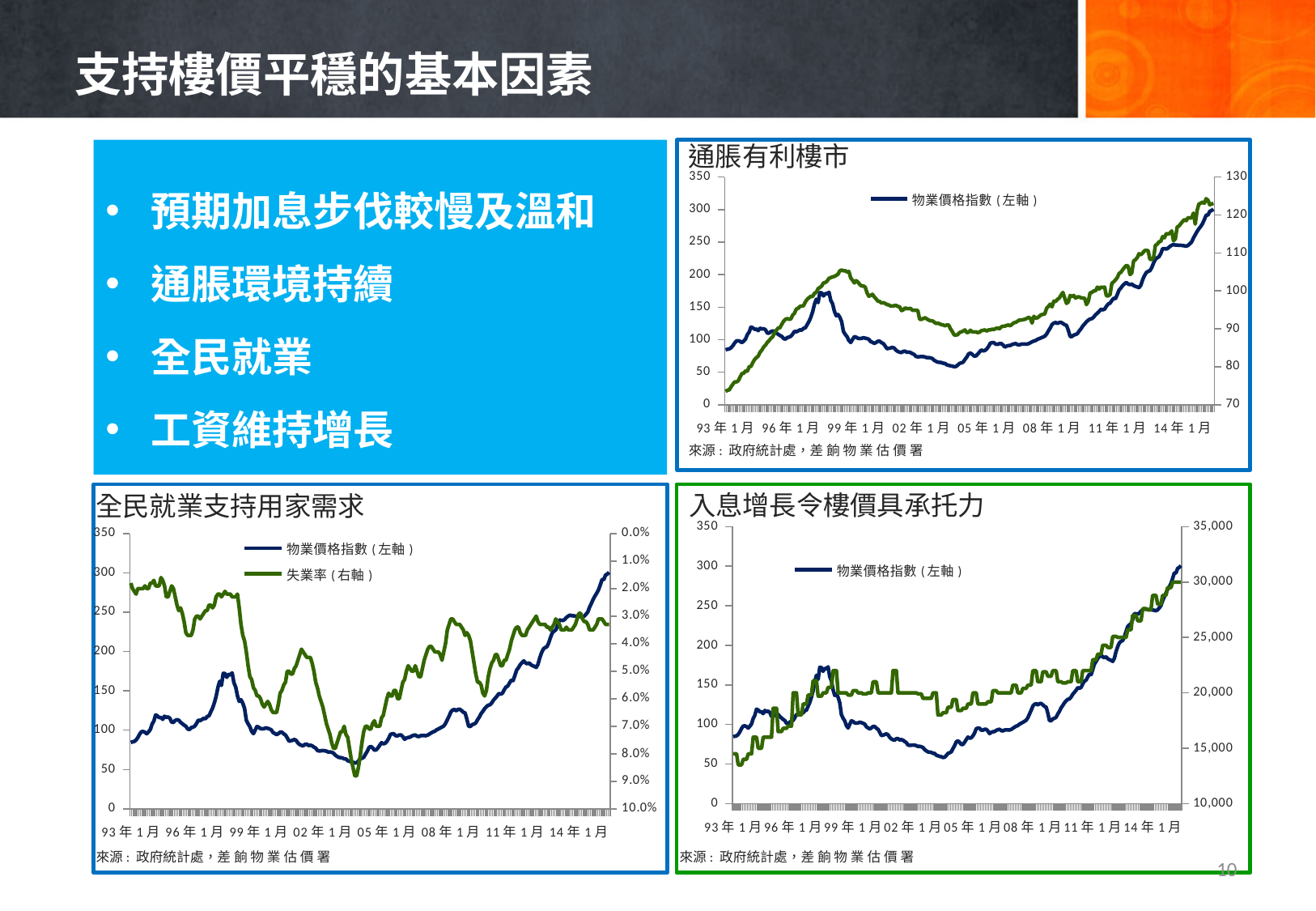
In the chart titled 通脹有利樓市, is the 物業價格指數 value at 05 年 1 月 greater or less than 100? less What kind of chart is the chart titled 通脹有利樓市? line chart What is the title of the chart in the top right of the slide? 通脹有利樓市 In the chart titled 全民就業支持用家需求, is the 物業價格指數 value at 14 年 1 月 greater or less than 200? greater In the chart titled 通脹有利樓市, does the 物業價格指數 rise or fall from 99 年 1 月 to 02 年 1 月? fall How many series does the legend of the chart titled 全民就業支持用家需求 list? 2 In the chart titled 全民就業支持用家需求, which series is plotted on the right axis according to the legend? 失業率 (右軸) How many year labels are shown on the x axis of the chart titled 入息增長令樓價具承托力? 8 In the chart titled 全民就業支持用家需求, is the highest 失業率 value shown greater or less than 8.0%? greater In the chart titled 入息增長令樓價具承托力, does the 物業價格指數 rise or fall from 11 年 1 月 to the end of the series? rise